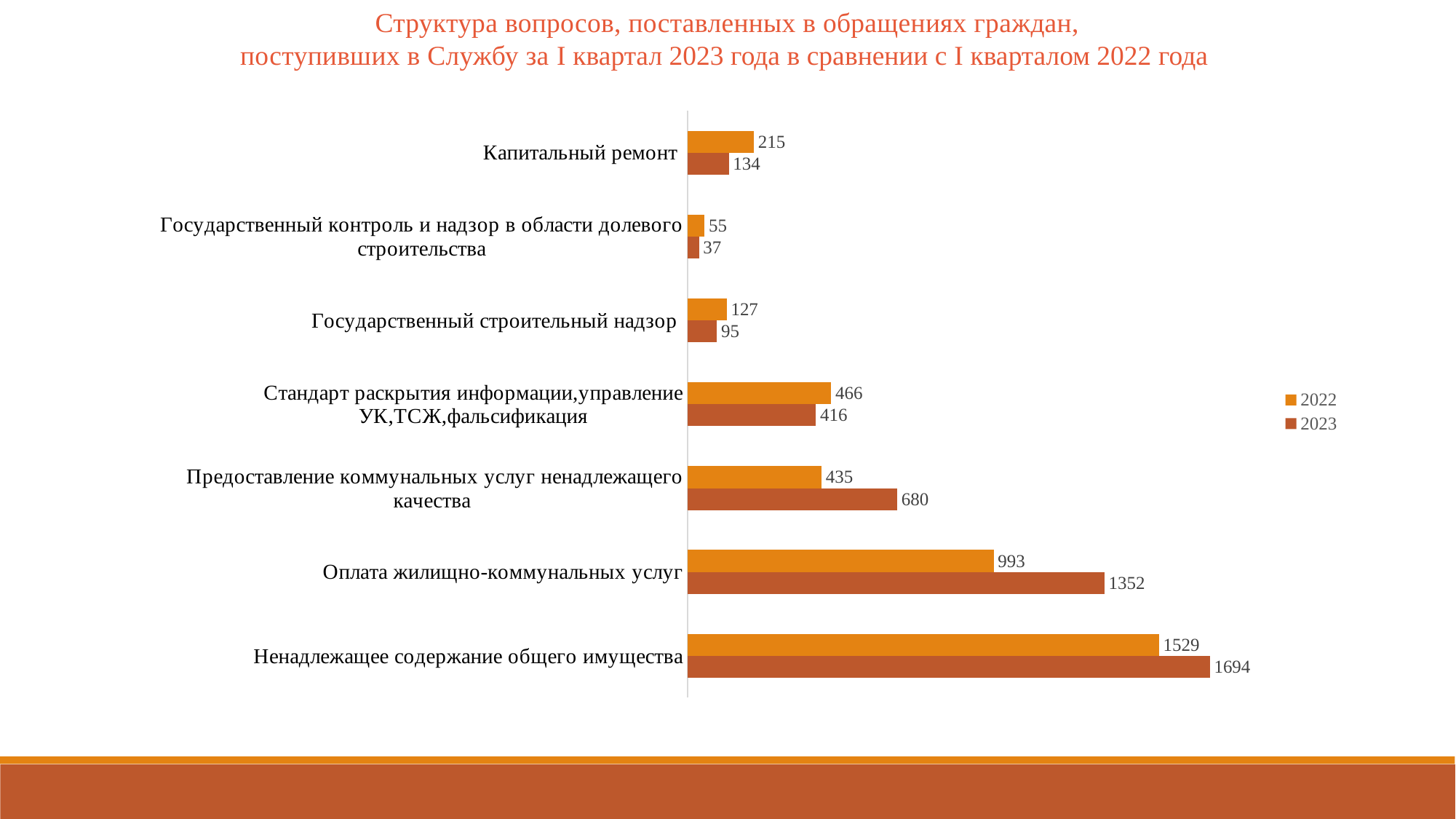
Which series is shown in the darker red-brown colour? 2023 Which category has the lowest 2022 value? Государственный контроль и надзор в области долевого строительства What is the 2022 value for Капитальный ремонт? 215 How many series does the legend list? 2 Which is larger for Стандарт раскрытия информации,управление УК,ТСЖ,фальсификация: the 2022 value or the 2023 value? 2022 What is the difference between the 2022 and 2023 values for Капитальный ремонт? 81 What is the difference between the 2023 and 2022 values for Предоставление коммунальных услуг ненадлежащего качества? 245 Which category has the highest 2023 value? Ненадлежащее содержание общего имущества How many categories are shown on the chart? 7 What kind of chart is shown on the slide? Bar chart What is the 2023 value for Оплата жилищно-коммунальных услуг? 1352 What is the 2023 value for Государственный строительный надзор? 95